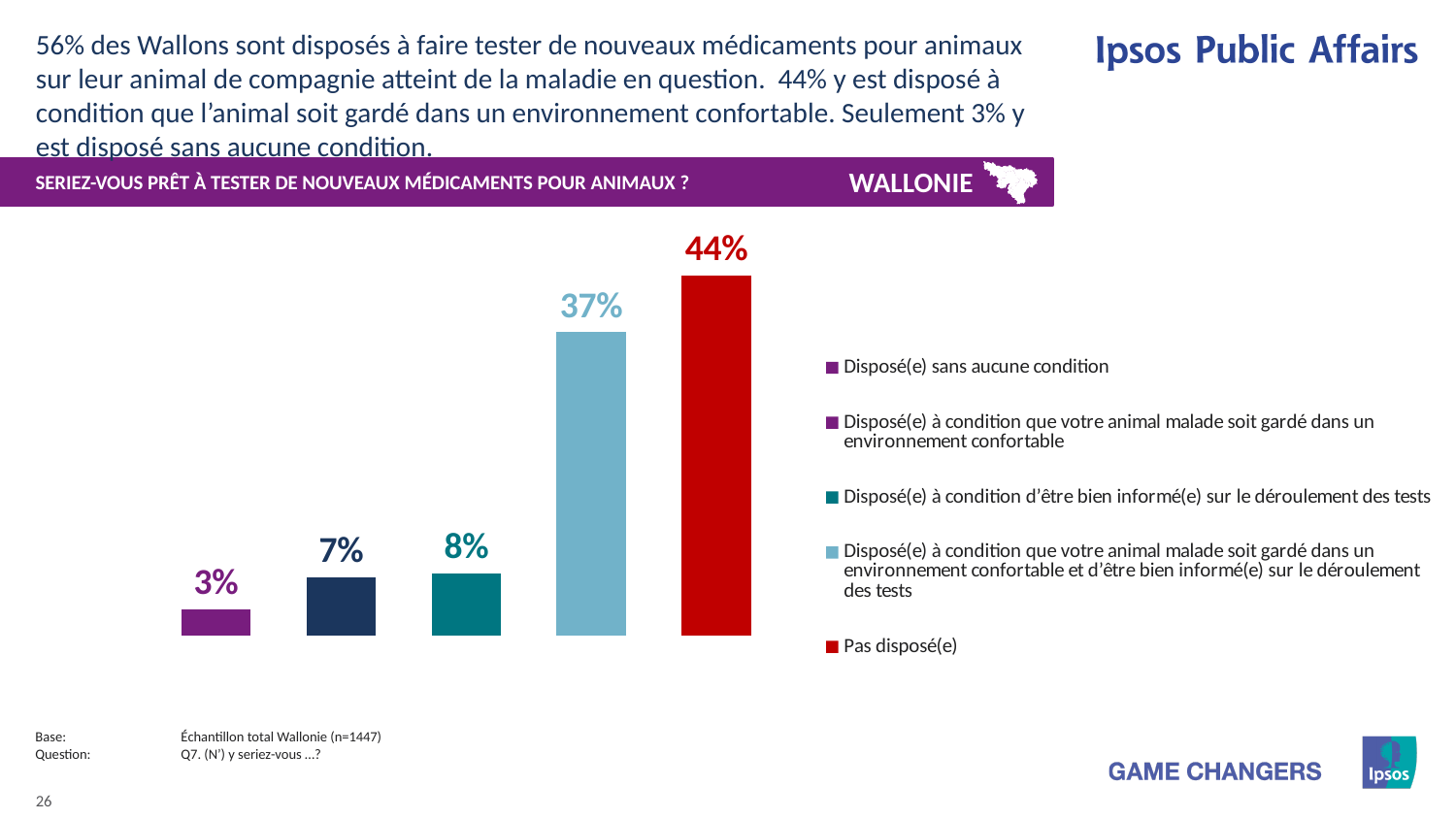
Which category has the highest value in the chart? Pas disposé(e) Which is larger: the value for "Disposé(e) à condition d'être bien informé(e) sur le déroulement des tests" or the value for "Disposé(e) sans aucune condition"? Disposé(e) à condition d'être bien informé(e) sur le déroulement des tests What is the difference between the value for "Pas disposé(e)" and the value for "Disposé(e) à condition que votre animal malade soit gardé dans un environnement confortable et d'être bien informé(e) sur le déroulement des tests"? 7% What kind of chart is shown on the slide? bar chart Which category has the lowest value in the chart? Disposé(e) sans aucune condition How many entries does the chart legend list? 5 What is the value for "Disposé(e) à condition que votre animal malade soit gardé dans un environnement confortable"? 7% What is the value for "Disposé(e) à condition d'être bien informé(e) sur le déroulement des tests"? 8% What colour is the bar for "Pas disposé(e)"? red What is the value for "Pas disposé(e)"? 44% How many bars are plotted in the chart? 5 What is the value for "Disposé(e) sans aucune condition"? 3%